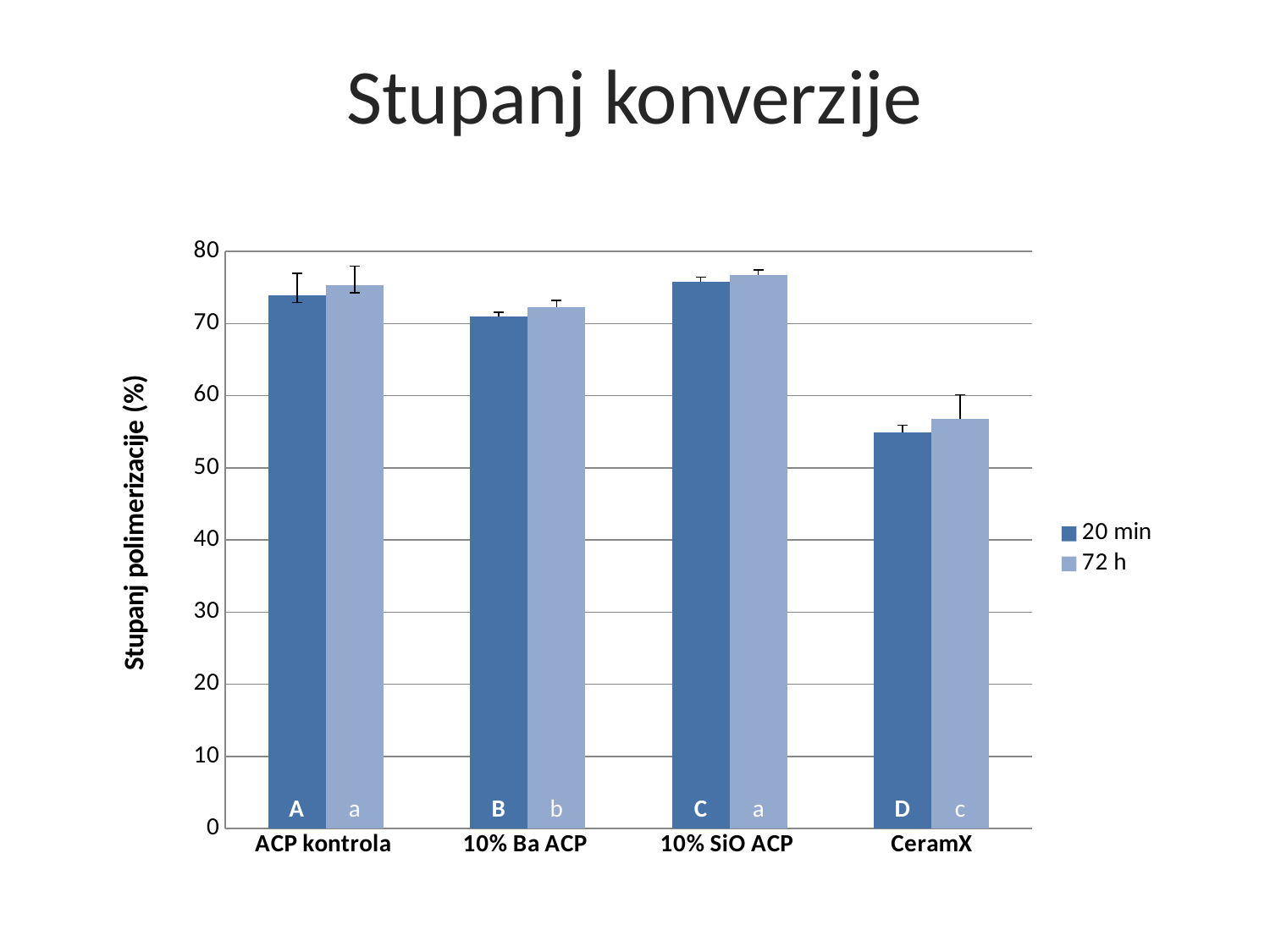
What kind of chart is shown on the slide? bar chart Is the 20 min value for CeramX greater or less than 60? less How many series does the chart's legend list? 2 Which is larger for the 72 h series: ACP kontrola or CeramX? ACP kontrola Which category has the lowest value for the 72 h series? CeramX Which is larger for the 20 min series: 10% Ba ACP or 10% SiO ACP? 10% SiO ACP Is the 72 h value for CeramX greater or less than 50? greater Is the 20 min value for ACP kontrola greater or less than 70? greater How many categories are shown on the x axis of the chart? 4 What is the title of the chart? Stupanj konverzije What are the two series listed in the chart's legend? 20 min and 72 h Which category has the lowest value for the 20 min series? CeramX